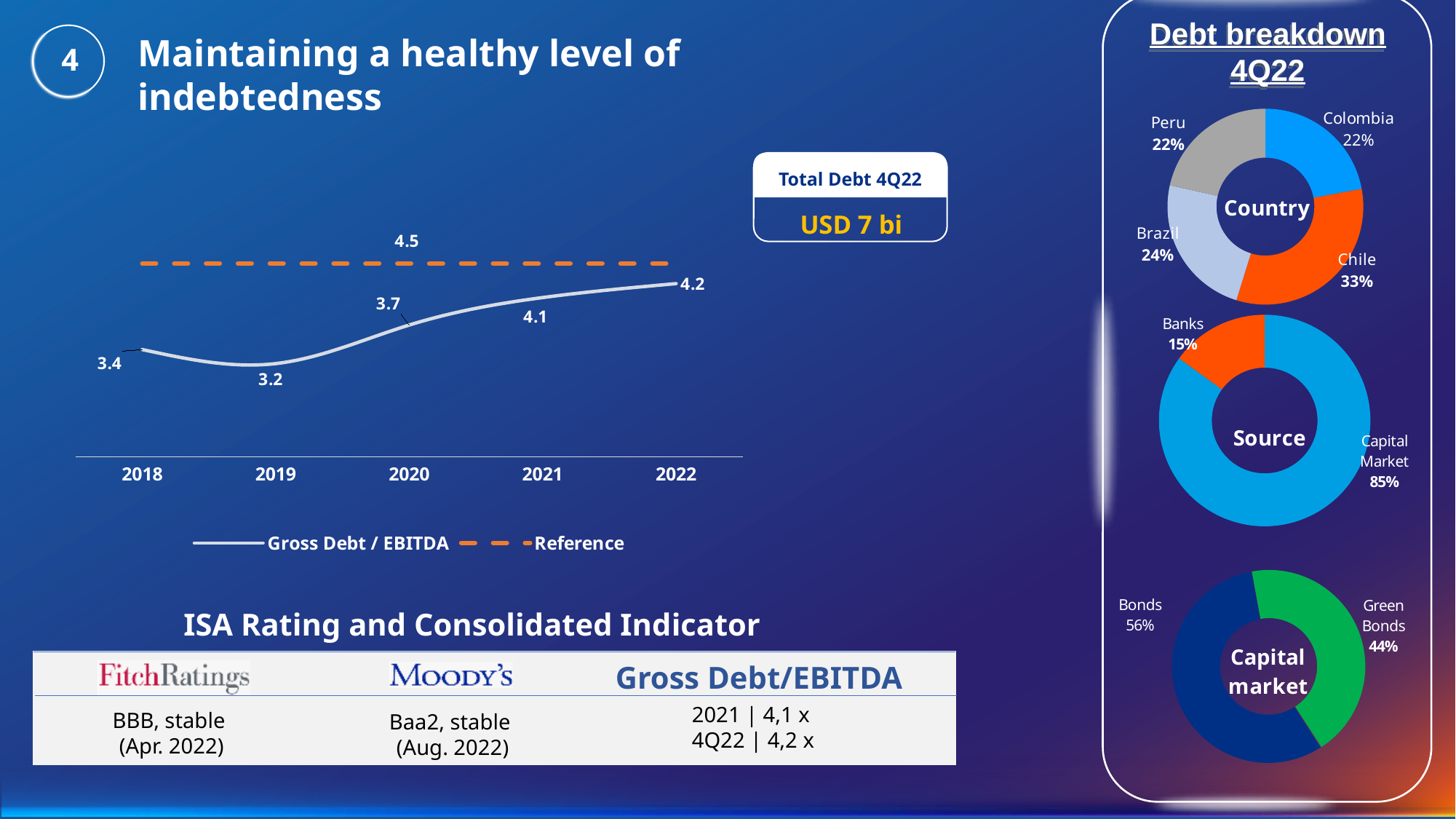
In the Source donut chart, what share does Banks have? 15% In the Capital market donut chart, which is larger, Bonds or Green Bonds? Bonds In the Gross Debt / EBITDA line chart, does the value rise or fall from 2019 to 2022? rise In the Country donut chart, which country has the largest share? Chile In the Country donut chart, what share does Chile have? 33% In the Gross Debt / EBITDA line chart, which year has the lowest Gross Debt / EBITDA value? 2019 In the Gross Debt / EBITDA line chart, how many years are shown on the x axis? 5 In the Gross Debt / EBITDA line chart, what is the value for 2022? 4.2 In the Gross Debt / EBITDA line chart, how many series does the legend list? 2 In the Gross Debt / EBITDA line chart, what is the value of the Reference line? 4.5 In the Gross Debt / EBITDA line chart, what is the value for 2019? 3.2 In the Gross Debt / EBITDA line chart, what is the difference between the 2022 value and the 2018 value? 0.8